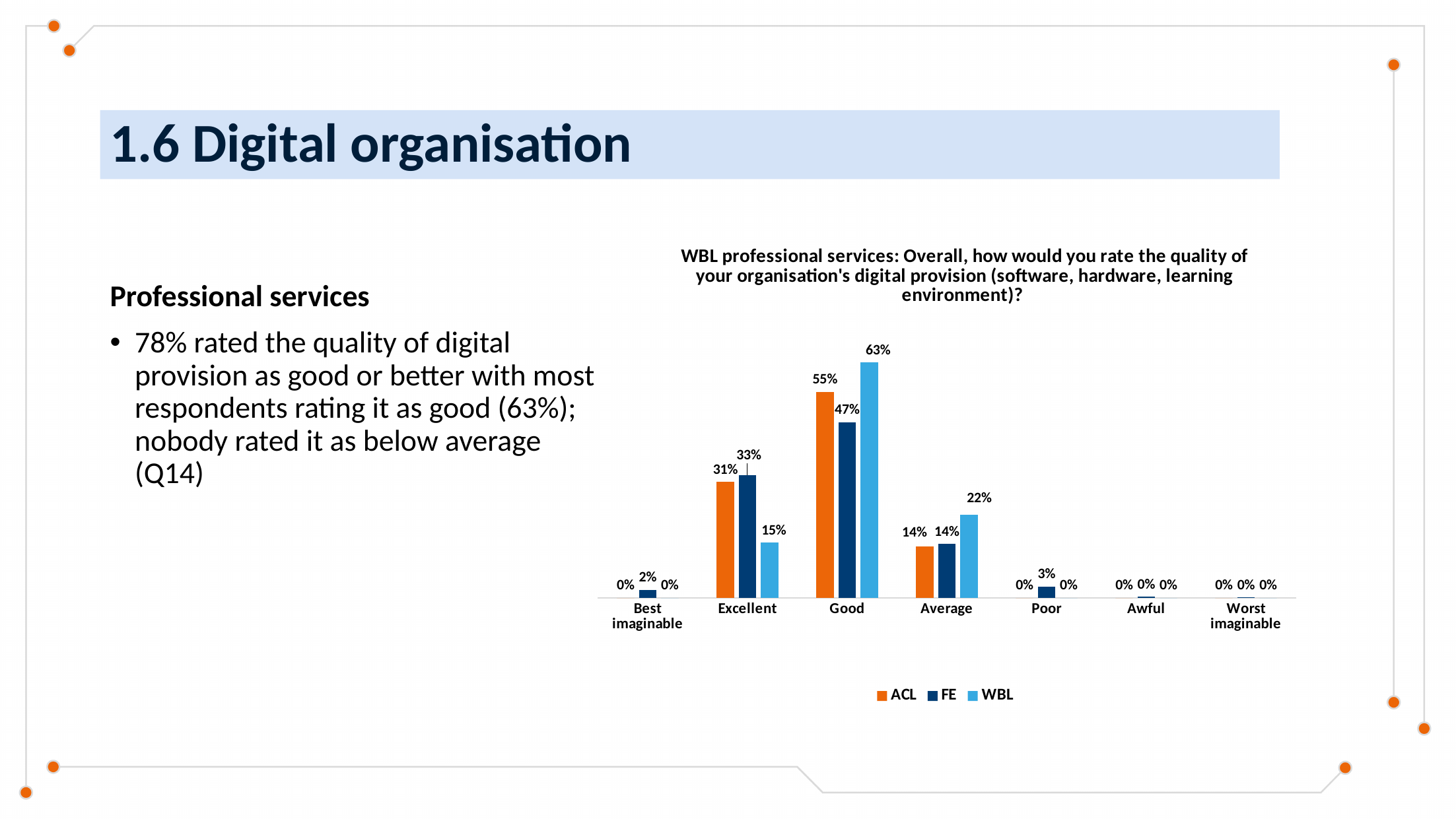
What is the ACL value for the Excellent category? 31% How many series does the legend list? 3 What is the WBL value for the Good category? 63% Which category has the highest WBL value? Good What is the difference between the WBL and FE values for the Good category? 16% Which is larger for the Excellent category, the ACL value or the WBL value? ACL What is the WBL value for the Average category? 22% Which series is shown in orange in the legend? ACL What kind of chart is shown on the slide? Bar chart What is the FE value for the Poor category? 3% What is the difference between the ACL and FE values for the Excellent category? 2% How many categories are shown on the x axis? 7